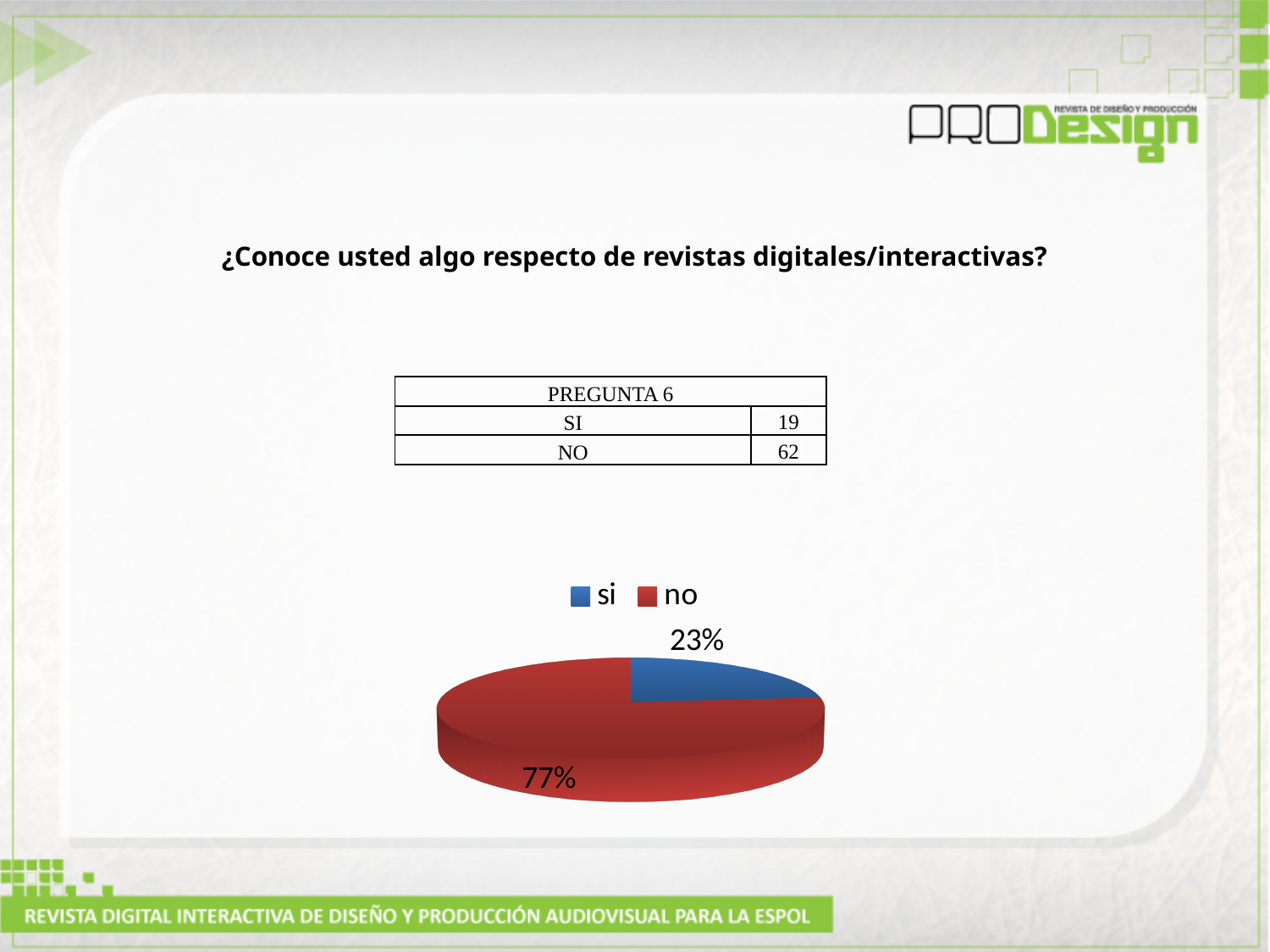
How many slices does the pie chart have? 2 What percentage of the pie chart is labelled for the "no" slice? 77% What colour is the "si" slice in the pie chart? blue Is the share of the "no" slice greater or less than 50%? greater Which is larger in the pie chart, the "si" slice or the "no" slice? no What kind of chart is shown on the slide? pie chart What percentage of the pie chart is labelled for the "si" slice? 23% Which slice of the pie chart is the smallest? si What colour is the "no" slice in the pie chart? red What is the difference in percentage points between the "no" slice and the "si" slice? 54 Which slice of the pie chart is the largest? no How many entries does the legend of the pie chart list? 2